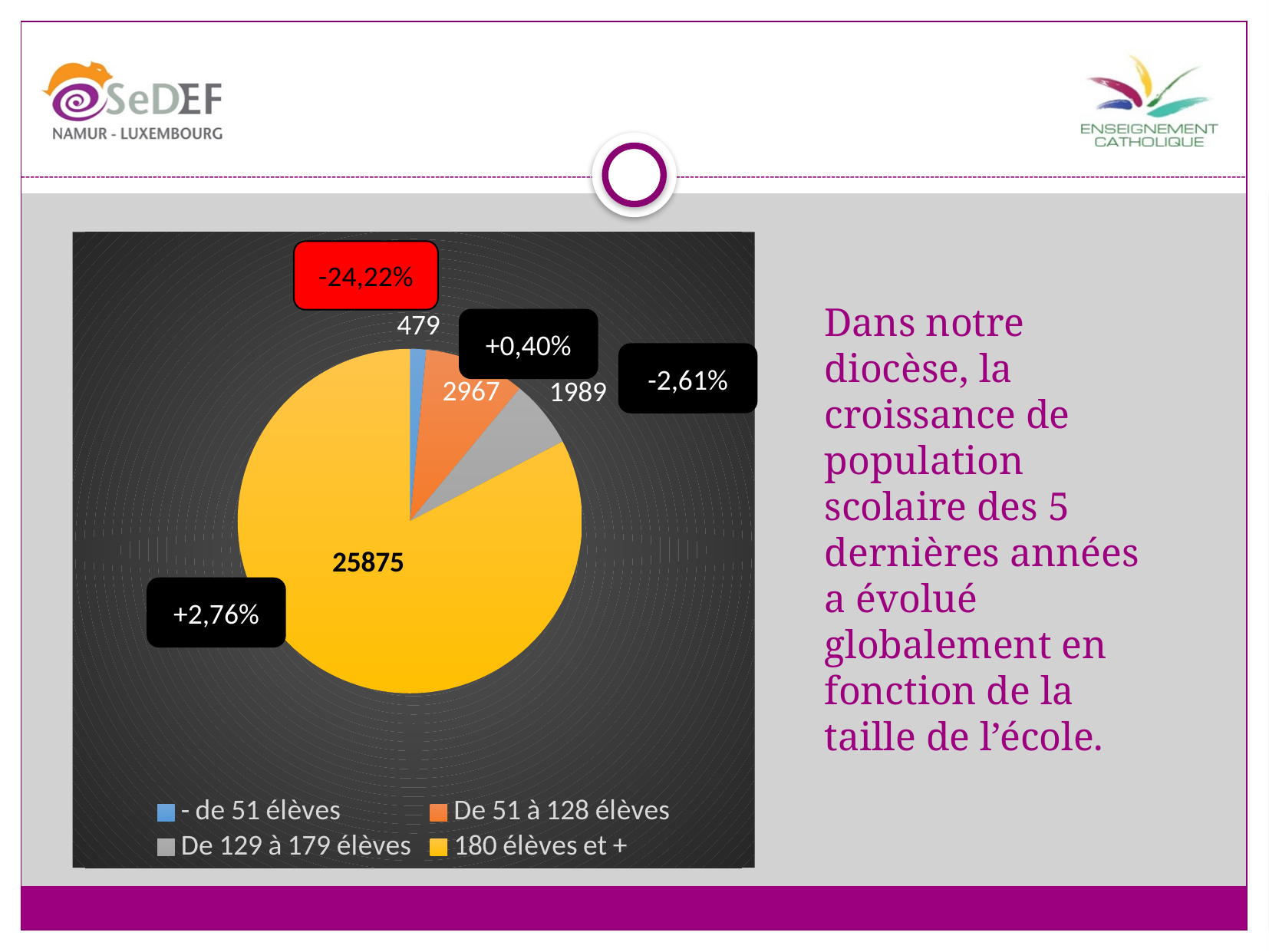
What kind of chart is shown on the slide? pie chart Which category has the largest slice of the pie? 180 élèves et + What is the value for the slice "De 51 à 128 élèves"? 2967 What is the value for the slice "De 129 à 179 élèves"? 1989 What percentage change is shown in the red callout next to the "- de 51 élèves" slice? -24,22% What colour is the slice for "180 élèves et +"? yellow How many slices does the pie chart have? 4 What is the difference between the values for "De 51 à 128 élèves" and "De 129 à 179 élèves"? 978 What is the value for the slice "180 élèves et +"? 25875 What is the value for the slice "- de 51 élèves"? 479 Which is larger, the value for "De 51 à 128 élèves" or the value for "De 129 à 179 élèves"? De 51 à 128 élèves Which category has the smallest slice of the pie? - de 51 élèves